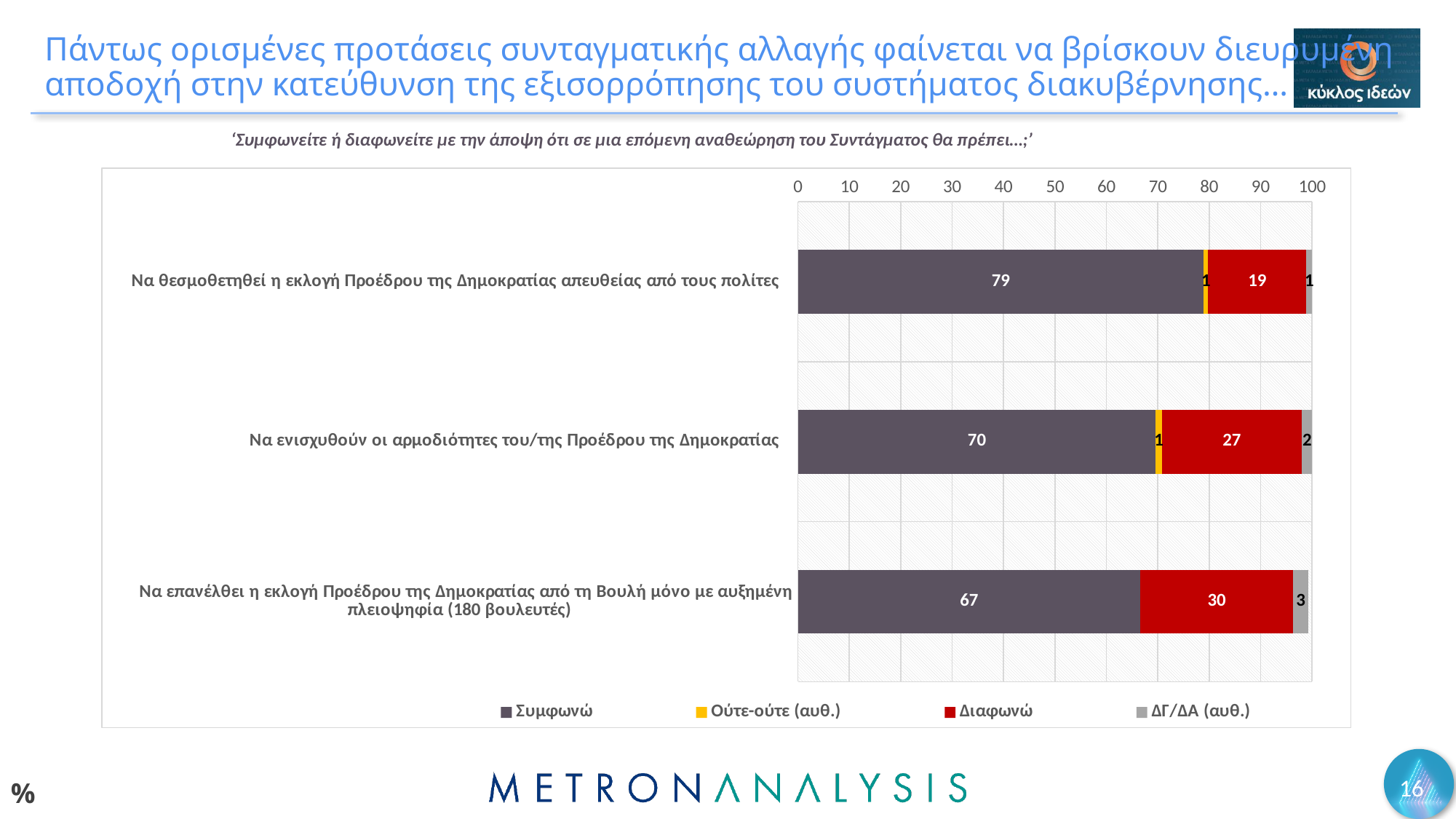
What is the 'ΔΓ/ΔΑ (αυθ.)' value for 'Να επανέλθει η εκλογή Προέδρου της Δημοκρατίας από τη Βουλή μόνο με αυξημένη πλειοψηφία (180 βουλευτές)'? 3 Which statement has the lowest 'Διαφωνώ' value? Να θεσμοθετηθεί η εκλογή Προέδρου της Δημοκρατίας απευθείας από τους πολίτες Which is larger: the 'Διαφωνώ' value for 'Να ενισχυθούν οι αρμοδιότητες του/της Προέδρου της Δημοκρατίας' or for 'Να επανέλθει η εκλογή Προέδρου της Δημοκρατίας από τη Βουλή μόνο με αυξημένη πλειοψηφία (180 βουλευτές)'? Να επανέλθει η εκλογή Προέδρου της Δημοκρατίας από τη Βουλή μόνο με αυξημένη πλειοψηφία (180 βουλευτές) Which colour represents 'Διαφωνώ' in the legend? red What kind of chart is shown on the slide? bar chart What is the 'Διαφωνώ' value for 'Να ενισχυθούν οι αρμοδιότητες του/της Προέδρου της Δημοκρατίας'? 27 How many categories (statements) are plotted in the chart? 3 Which statement has the highest 'Συμφωνώ' value? Να θεσμοθετηθεί η εκλογή Προέδρου της Δημοκρατίας απευθείας από τους πολίτες How many series does the legend list? 4 What is the total of the stacked bar for 'Να ενισχυθούν οι αρμοδιότητες του/της Προέδρου της Δημοκρατίας'? 100 What is the difference between the 'Συμφωνώ' values for 'Να θεσμοθετηθεί η εκλογή Προέδρου της Δημοκρατίας απευθείας από τους πολίτες' and 'Να επανέλθει η εκλογή Προέδρου της Δημοκρατίας από τη Βουλή μόνο με αυξημένη πλειοψηφία (180 βουλευτές)'? 12 What is the 'Συμφωνώ' value for 'Να θεσμοθετηθεί η εκλογή Προέδρου της Δημοκρατίας απευθείας από τους πολίτες'? 79